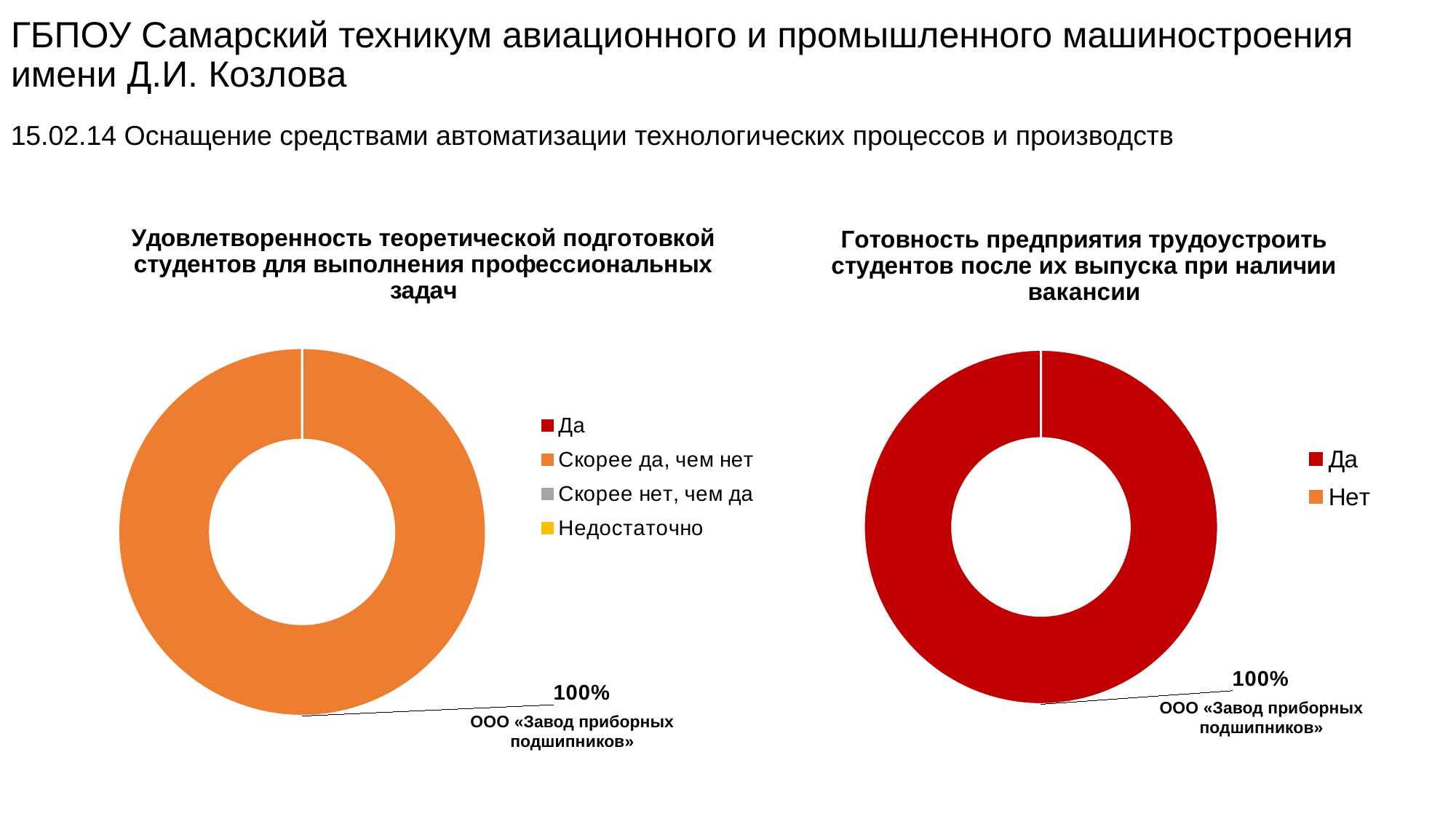
In the left chart (Удовлетворенность теоретической подготовкой), which legend category does the entire ring belong to? Скорее да, чем нет In the right chart (Готовность предприятия трудоустроить студентов), what percentage is shown on the data label? 100% In the left chart (Удовлетворенность теоретической подготовкой), what share of the ring is «Скорее да, чем нет»? 100% What kind of chart is the left chart titled «Удовлетворенность теоретической подготовкой студентов для выполнения профессиональных задач»? Doughnut (pie) chart How many entries does the legend of the left chart (Удовлетворенность теоретической подготовкой) list? 4 In the left chart (Удовлетворенность теоретической подготовкой), what percentage is shown on the data label? 100% What colour is the ring in the right chart (Готовность предприятия трудоустроить студентов)? Red How many entries does the legend of the right chart (Готовность предприятия трудоустроить студентов) list? 2 What kind of chart is the right chart titled «Готовность предприятия трудоустроить студентов после их выпуска при наличии вакансии»? Doughnut (pie) chart In the right chart (Готовность предприятия трудоустроить студентов), which legend category does the entire ring belong to? Да In the right chart (Готовность предприятия трудоустроить студентов), what share of the ring is «Да»? 100% Which enterprise is named in the data label of the right chart (Готовность предприятия трудоустроить студентов)? ООО «Завод приборных подшипников»